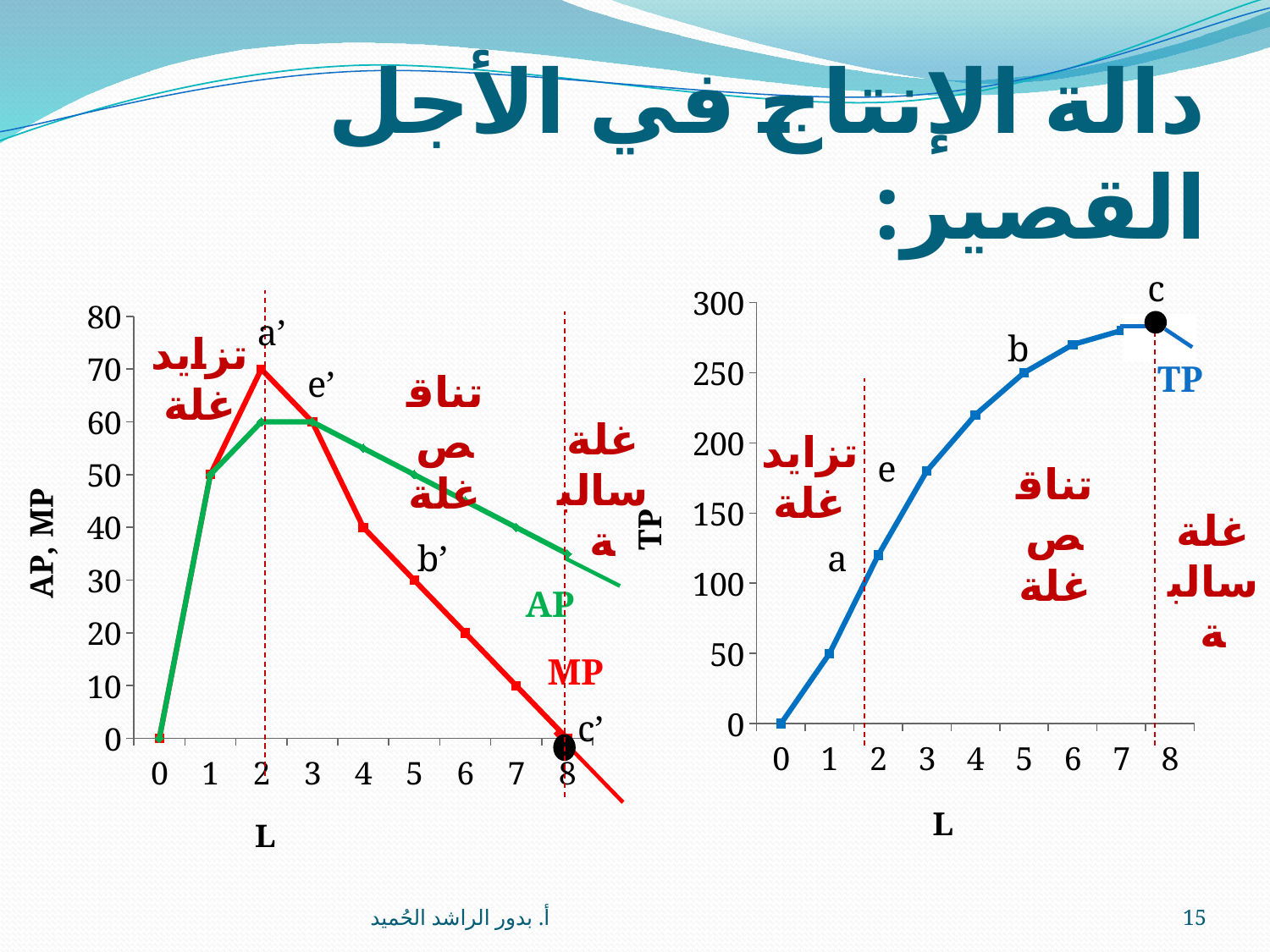
On the right chart (TP against L), is the value of TP at L = 2 greater or less than 100? greater On the left chart, what is the value of MP at L = 2? 70 On the left chart, what is the value of MP at L = 8? 0 On the left chart, at L = 4, which is larger, AP or MP? AP On the right chart (TP against L), what is the value of TP at L = 1? 50 On the left chart, at which value of L does MP reach its highest point? 2 What kind of chart is the left chart (AP, MP against L)? line chart On the right chart (TP against L), what is the value of TP at L = 5? 250 On the left chart, does MP rise or fall as L increases from 2 to 8? fall How many series are plotted on the left chart (AP, MP against L)? 2 On the right chart, what is the label of the plotted series? TP On the right chart (TP against L), is the value of TP at L = 3 greater or less than 150? greater